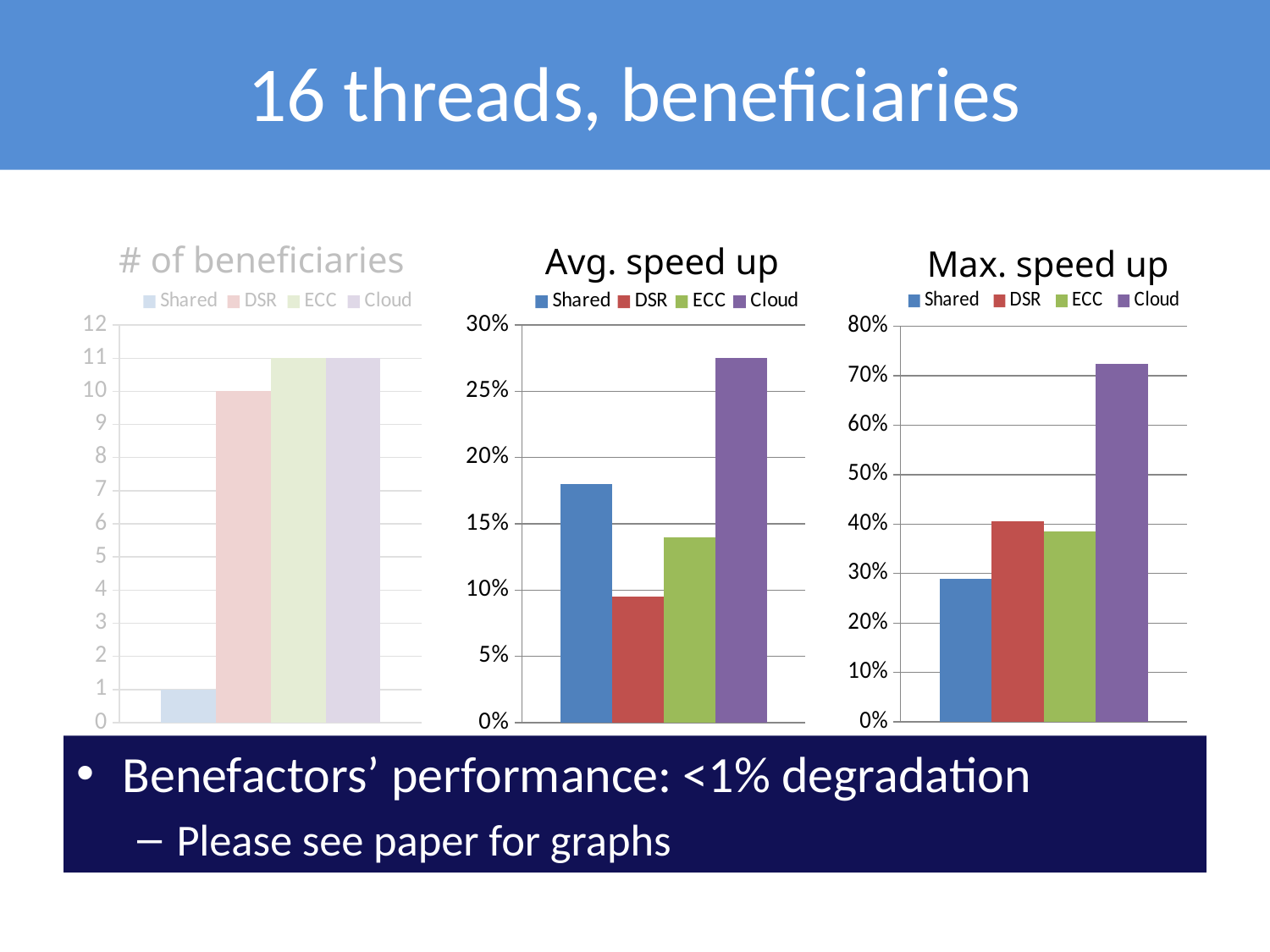
In the 'Max. speed up' chart, which series has the highest value? Cloud In the 'Max. speed up' chart, which series has the lowest value? Shared In the '# of beneficiaries' chart, what is the difference between the values for DSR and Shared? 9 How many series does the legend of the 'Max. speed up' chart list? 4 In the '# of beneficiaries' chart, what is the value for DSR? 10 In the 'Avg. speed up' chart, is the value for Cloud greater or less than 25%? greater In the 'Avg. speed up' chart, which series has the lowest value? DSR In the 'Avg. speed up' chart, which series has the highest value? Cloud In the '# of beneficiaries' chart, which series has the lowest value? Shared In the 'Avg. speed up' chart, is the value for Shared greater or less than 15%? greater In the 'Max. speed up' chart, is the value for Cloud greater or less than 70%? greater In the '# of beneficiaries' chart, what is the value for Shared? 1